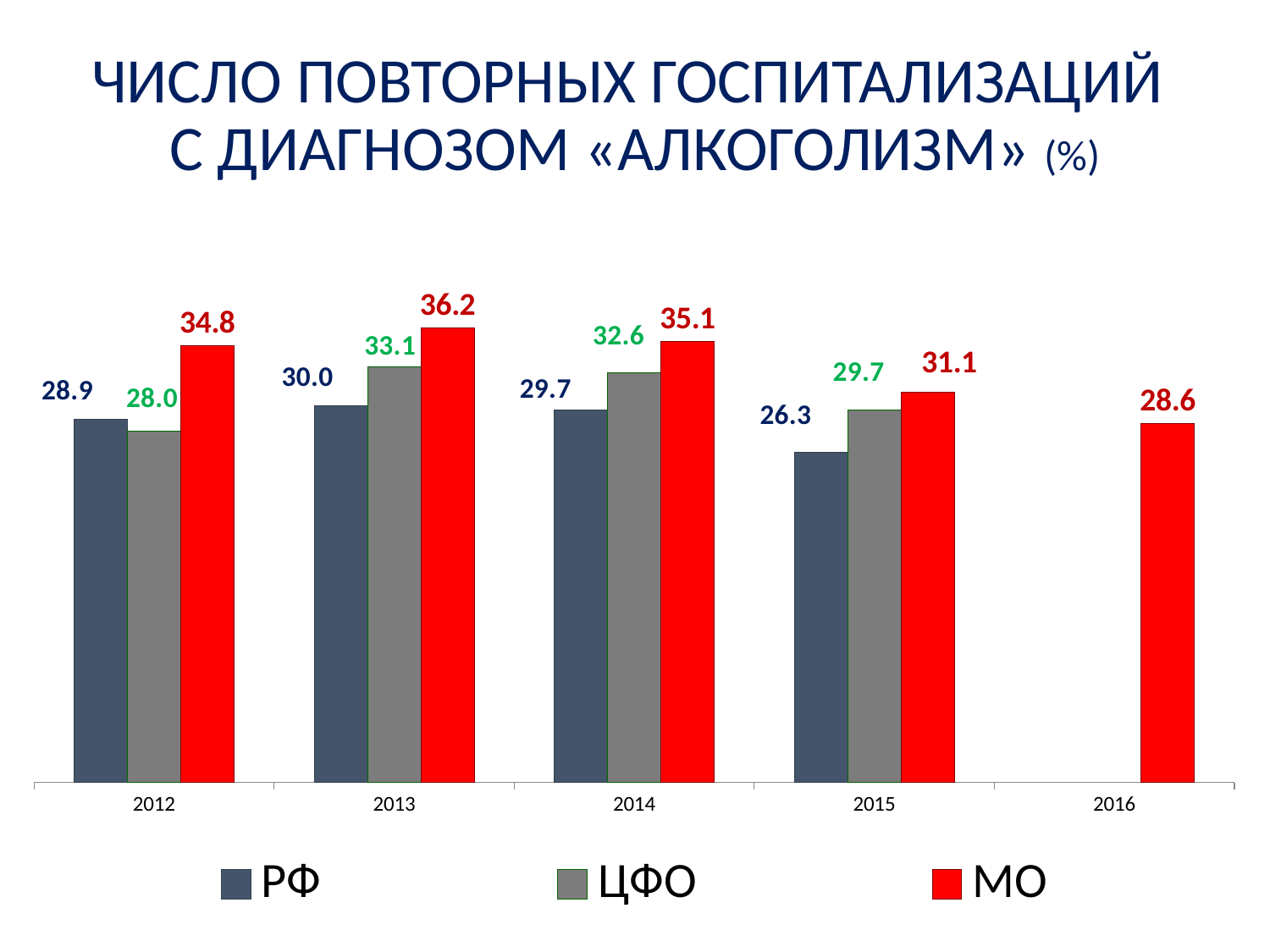
How many years are shown on the x axis? 5 What kind of chart is shown on the slide? bar chart What is the value for ЦФО in 2014? 32.6 Which is larger in 2015: the ЦФО value or the РФ value? ЦФО Does the МО value rise or fall from 2013 to 2016? fall In which year is the РФ value lowest? 2015 Which series is shown in red in the legend? МО What is the value for МО in 2013? 36.2 In which year is the МО value highest? 2013 What is the difference between the МО and РФ values in 2012? 5.9 How many series does the legend list? 3 What is the value for РФ in 2015? 26.3